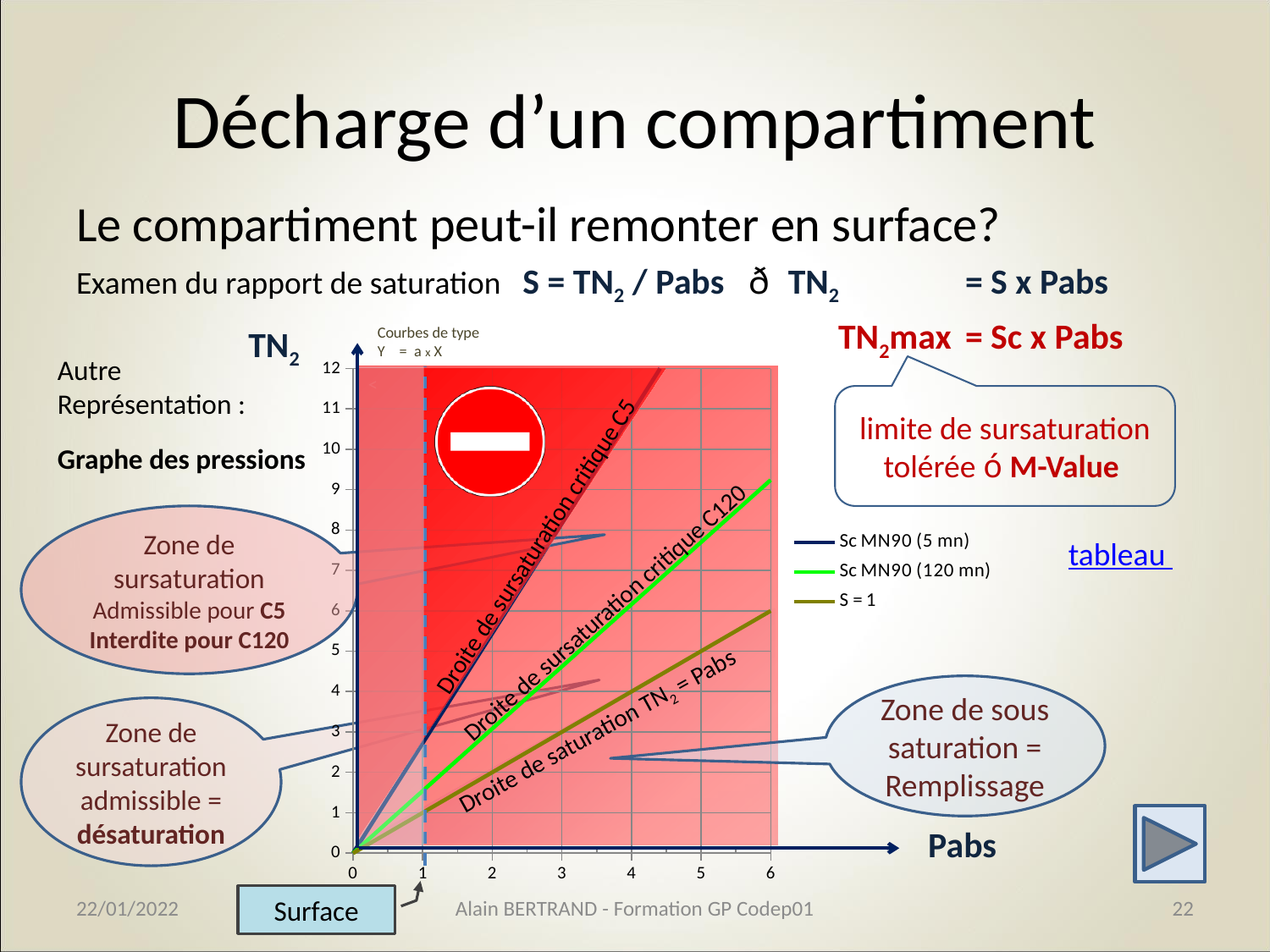
What is the label of the chart's horizontal axis? Pabs At Pabs = 3, which line is higher: Sc MN90 (5 mn) or S = 1? Sc MN90 (5 mn) How many series does the chart legend list? 3 Do the values of the S = 1 series rise or fall as Pabs increases? rise At Pabs = 6, is the value of the S = 1 line greater or less than 8? less What are the three series named in the chart legend? Sc MN90 (5 mn), Sc MN90 (120 mn), S = 1 At Pabs = 6, is the value of the Sc MN90 (120 mn) line greater or less than 8? greater What is the highest value shown on the chart's horizontal axis? 6 What kind of chart is shown on the slide? line chart Do the values of the Sc MN90 (120 mn) series rise or fall as Pabs increases? rise What is the highest value shown on the chart's vertical axis? 12 Which series has the lowest value at Pabs = 5? S = 1